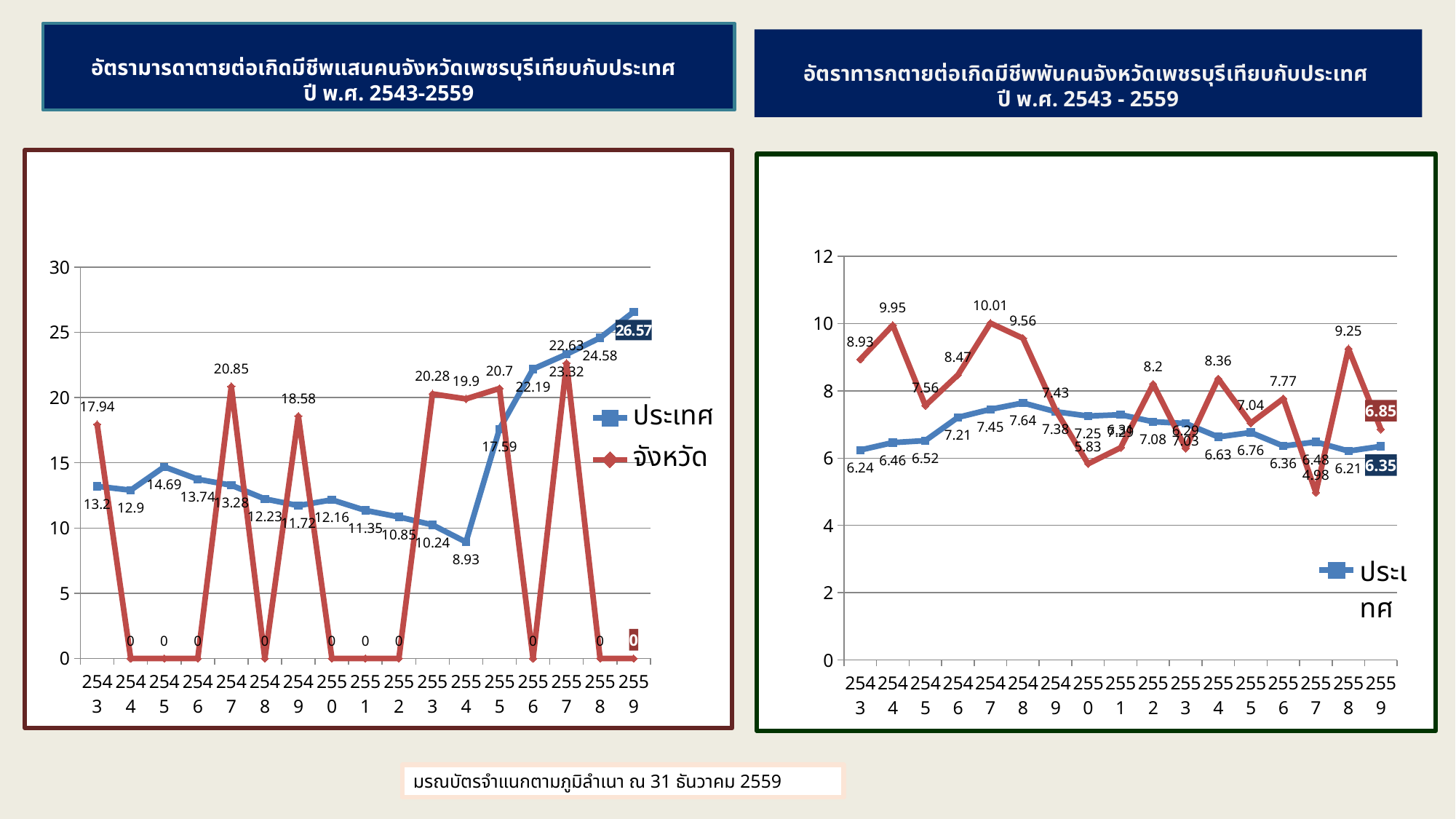
What type of chart is the left chart? line chart How many series does the legend of the left chart list? 2 How many years are shown on the x axis of the right chart? 17 On the right chart, what is the value for the red series in 2547? 10.01 On the right chart, what is the value for ประเทศ in 2559? 6.35 On the left chart, in which year is the ประเทศ series lowest? 2554 On the left chart, what is the difference between the ประเทศ values in 2559 and 2558? 1.99 On the left chart, what is the value for จังหวัด in 2547? 20.85 On the left chart, what is the value for ประเทศ in 2559? 26.57 On the right chart, which is larger in 2558: the red series or ประเทศ? the red series On the left chart, what is the value for ประเทศ in 2554? 8.93 On the right chart, in which year is the red series lowest? 2557